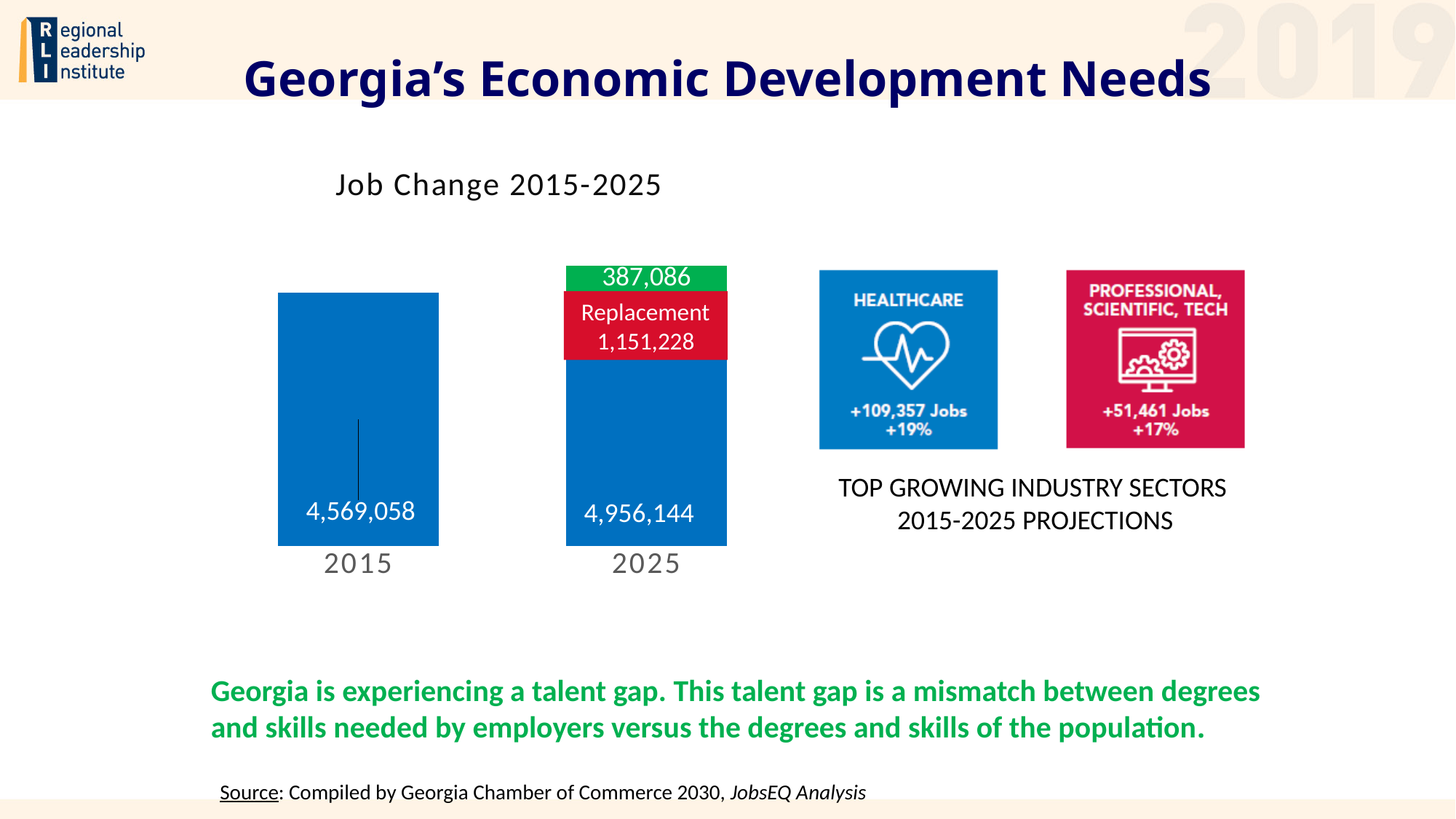
In the Top Growing Industry Sectors panel, what percentage growth is shown for Professional, Scientific, Tech? +17% In the Top Growing Industry Sectors panel, which sector has the larger projected job growth, Healthcare or Professional, Scientific, Tech? Healthcare In the Job Change 2015-2025 chart, what is the Replacement value shown for 2025? 1,151,228 What kind of chart is the Job Change 2015-2025 chart? Bar chart In the Job Change 2015-2025 chart, what colour is the Replacement segment? Red In the Job Change 2015-2025 chart, what is the difference between the blue 2025 value and the 2015 value? 387,086 In the Job Change 2015-2025 chart, what is the value shown for 2015? 4,569,058 In the Job Change 2015-2025 chart, what is the total of all segments in the 2025 stacked bar? 6,494,458 In the Job Change 2015-2025 chart, how many years are shown on the x axis? 2 In the Top Growing Industry Sectors panel, how many jobs are projected to be added in Healthcare? +109,357 Jobs In the Job Change 2015-2025 chart, what is the value of the blue segment for 2025? 4,956,144 In the Job Change 2015-2025 chart, what value is shown in the green segment at the top of the 2025 bar? 387,086